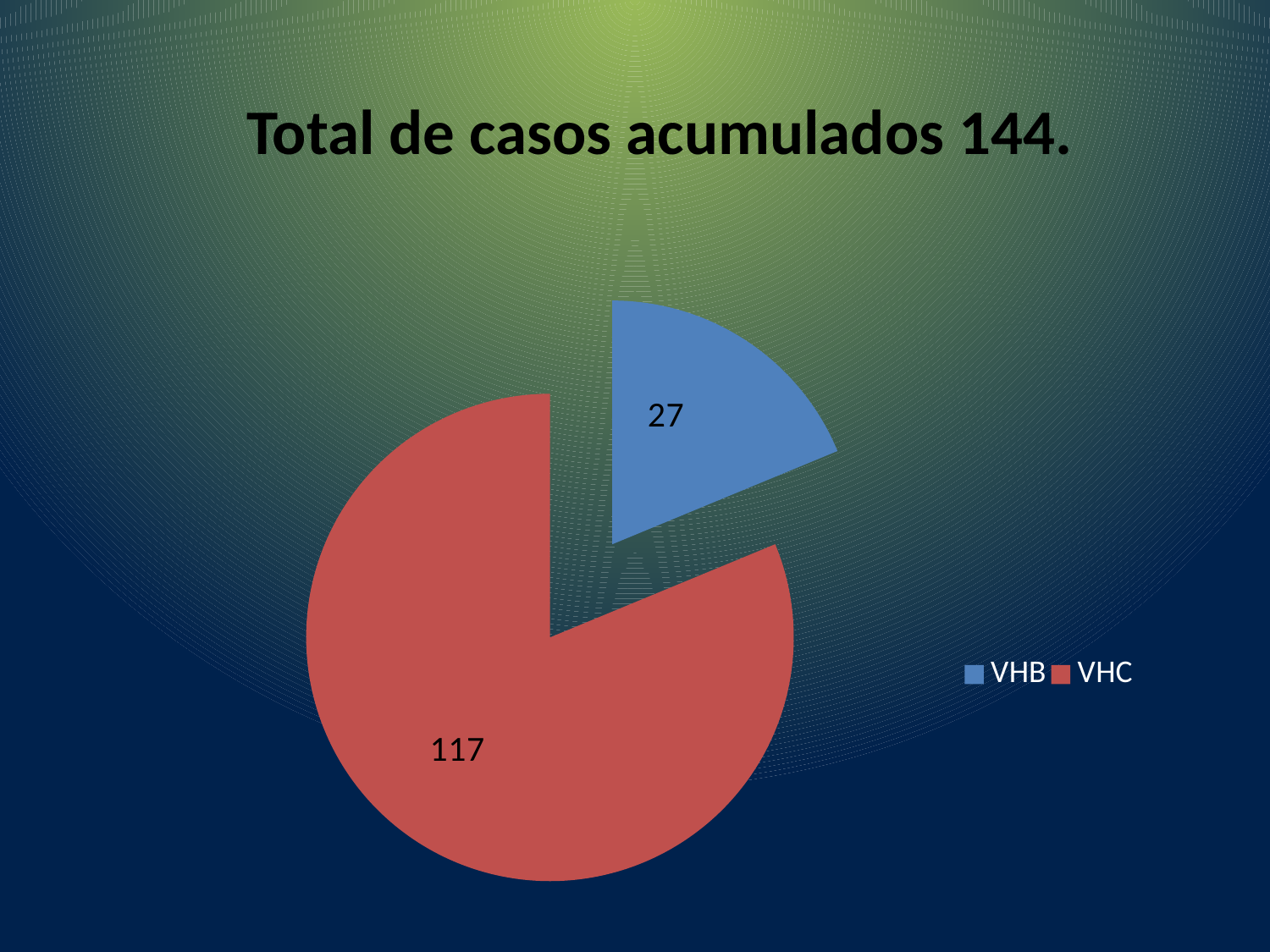
What kind of chart is shown on the slide? pie chart What is the total of all slices in the pie chart? 144 Which category has the largest slice of the pie? VHC What share of the pie does VHB represent? 18.75% Which category has the smallest slice of the pie? VHB What is the difference between the values for VHC and VHB? 90 How many entries does the legend list? 2 What is the title of the chart? Total de casos acumulados 144. What is the value for VHC? 117 What is the value for VHB? 27 Which is larger, the value for VHB or the value for VHC? VHC How many slices does the pie chart have? 2